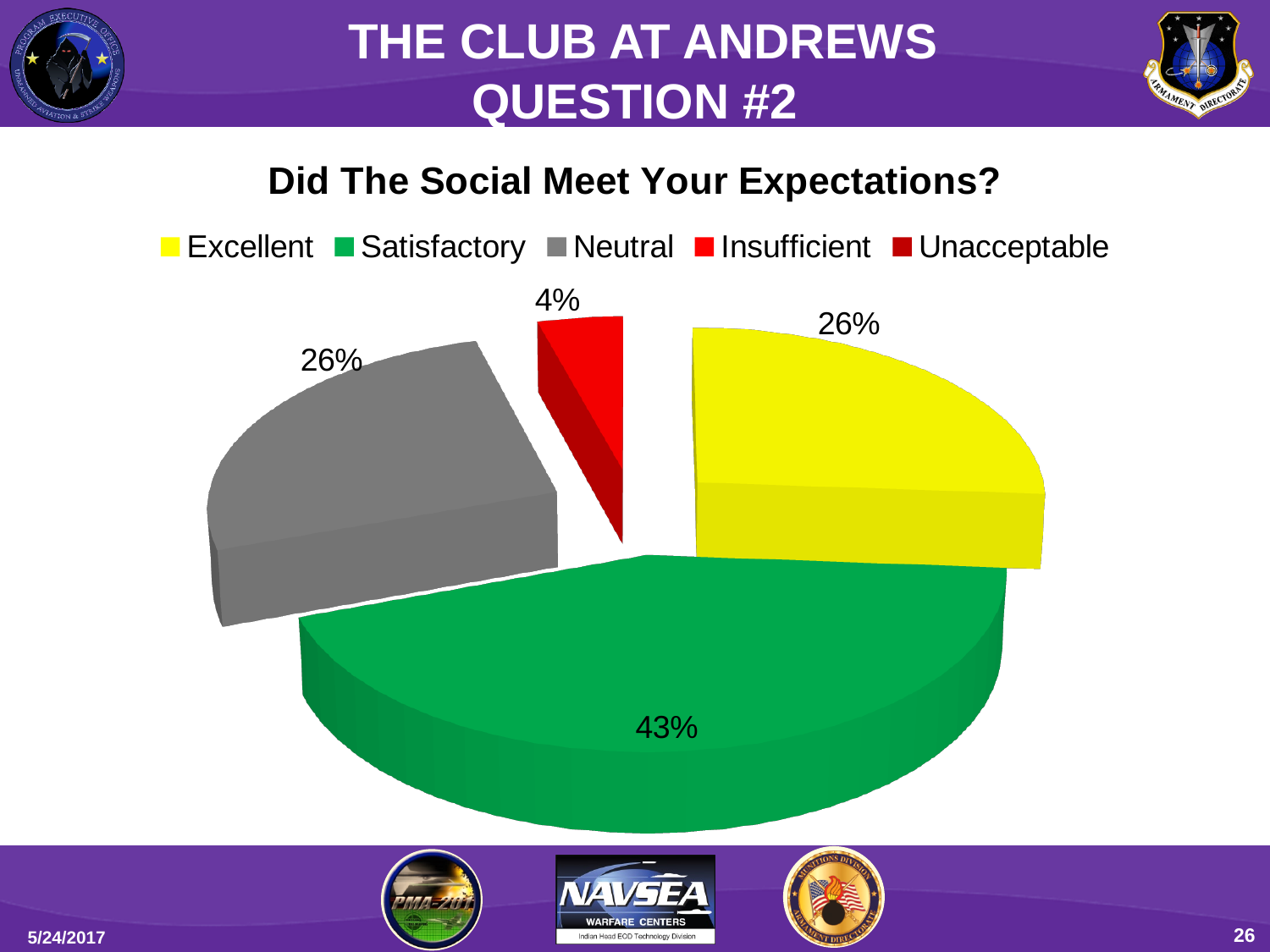
Which is larger, the share for Satisfactory or the share for Neutral? Satisfactory What percentage of responses were Satisfactory? 43% What is the title of the chart? Did The Social Meet Your Expectations? What kind of chart is shown on the slide? pie chart Which category has the largest share of the pie? Satisfactory By how many percentage points does the Satisfactory share exceed the Excellent share? 17 percentage points Which is larger, the share for Excellent or the share for Insufficient? Excellent Which category has the smallest slice shown on the pie? Insufficient What percentage of responses were Insufficient? 4% What percentage of responses were Neutral? 26% What percentage of responses were Excellent? 26% How many categories does the legend list? 5